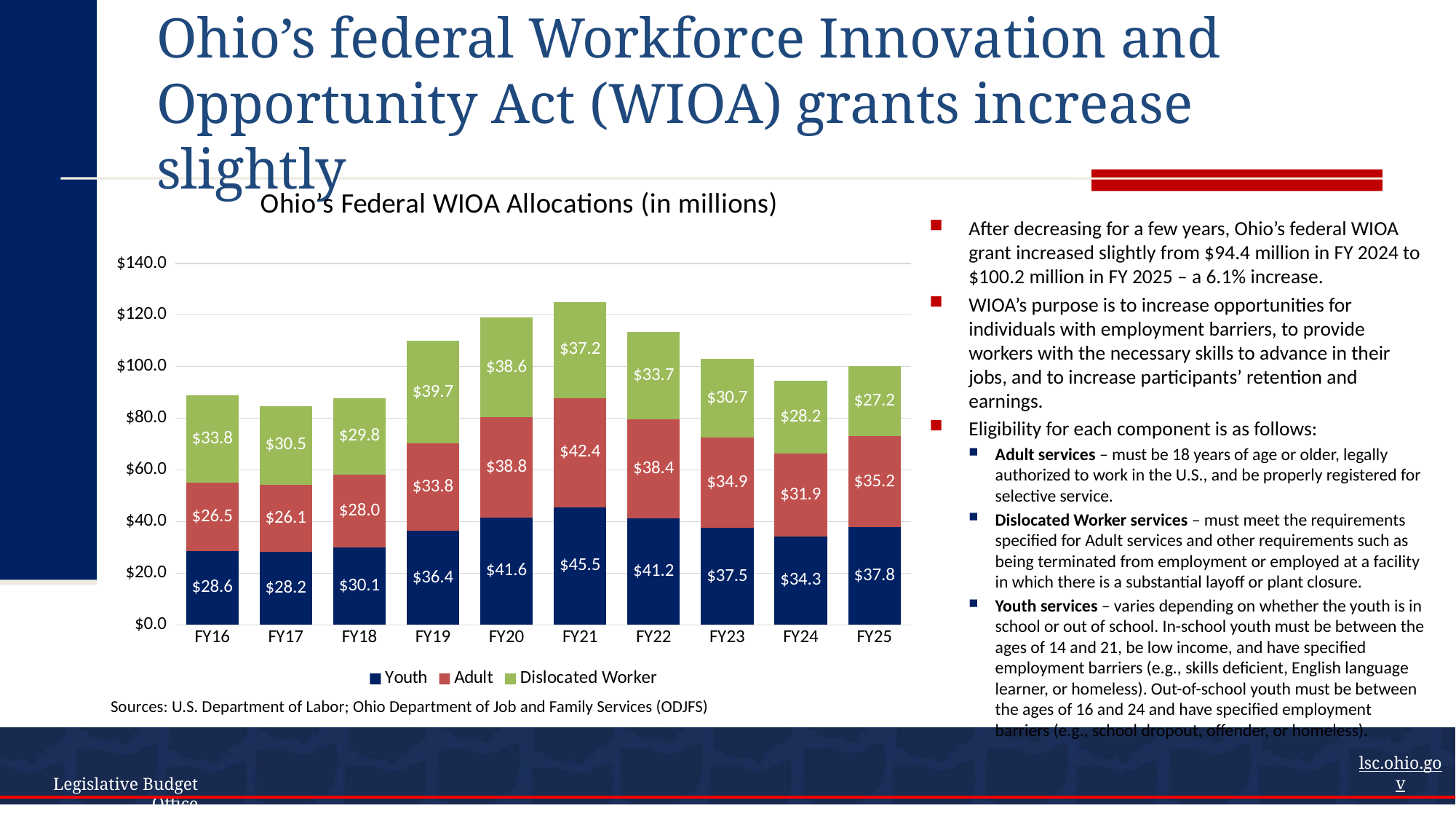
What is the total allocation for FY16 (sum of Youth, Adult and Dislocated Worker)? $88.9 In which fiscal year is the Dislocated Worker allocation lowest? FY25 How much larger is the Youth allocation in FY25 than in FY24? $3.5 How many fiscal years are shown on the x axis? 10 What kind of chart is shown on the slide? Stacked bar chart How many series does the legend list? 3 What is the Dislocated Worker allocation for FY19? $39.7 What is the Adult allocation for FY21? $42.4 Is the total stacked bar for FY21 greater or less than $120.0? greater Which is larger in FY20, the Adult allocation or the Dislocated Worker allocation? Adult What is the Youth allocation for FY25? $37.8 In which fiscal year is the Youth allocation highest? FY21